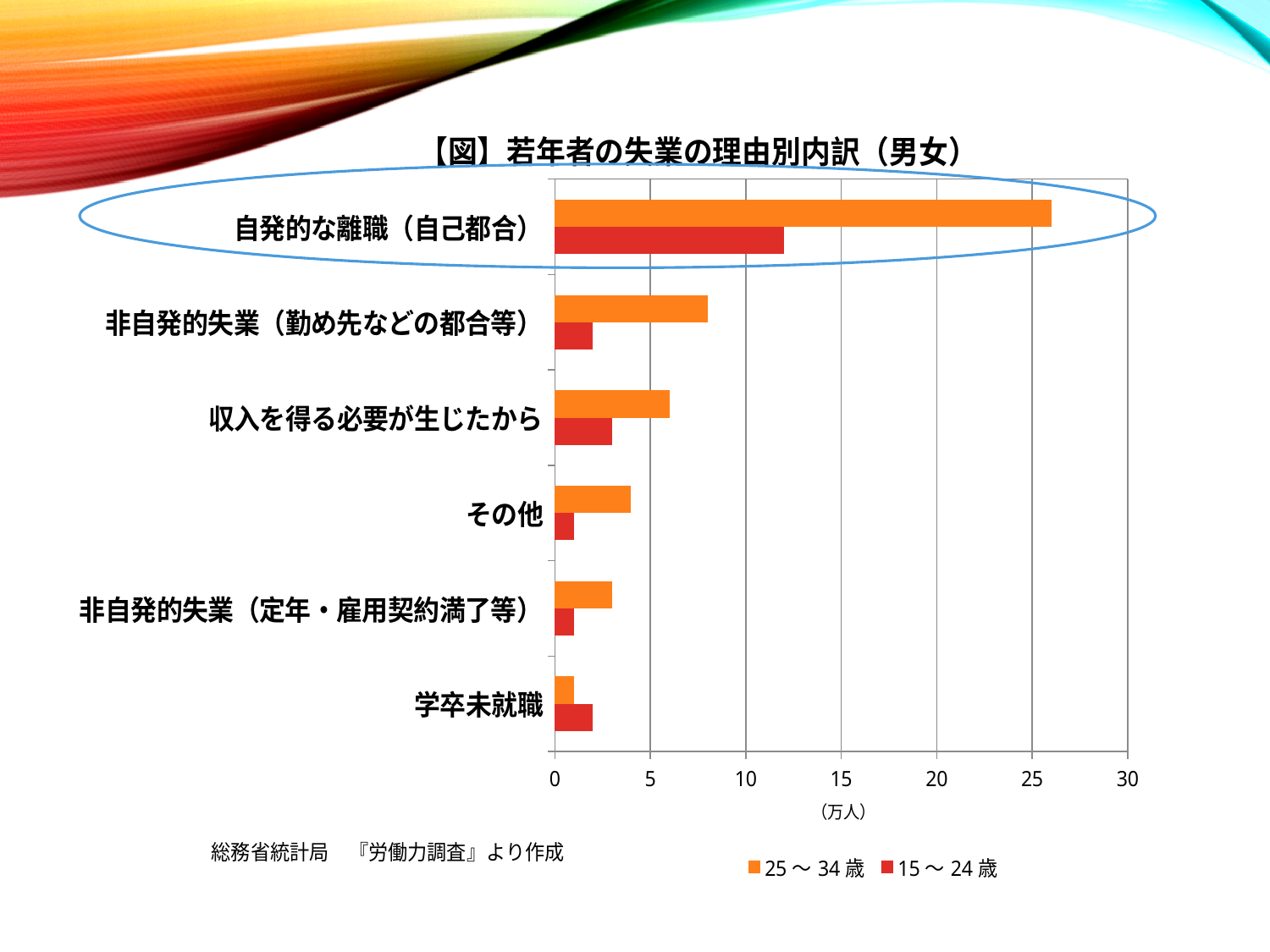
Is the value for 自発的な離職（自己都合） in the 15〜24歳 series greater or less than 10? greater Is the value for 非自発的失業（勤め先などの都合等） in the 25〜34歳 series greater or less than 5? greater Which category has the lowest value for the 25〜34歳 series? 学卒未就職 What kind of chart is shown on the slide? bar chart How many categories (reasons for unemployment) are shown on the chart? 6 What unit is shown on the horizontal axis of the chart? 万人 Is the value for 自発的な離職（自己都合） in the 25〜34歳 series greater or less than 20? greater Which category has the highest value for the 15〜24歳 series? 自発的な離職（自己都合） Which category has the highest value for the 25〜34歳 series? 自発的な離職（自己都合） For 学卒未就職, which series has the larger value, 25〜34歳 or 15〜24歳? 15〜24歳 How many series does the legend list? 2